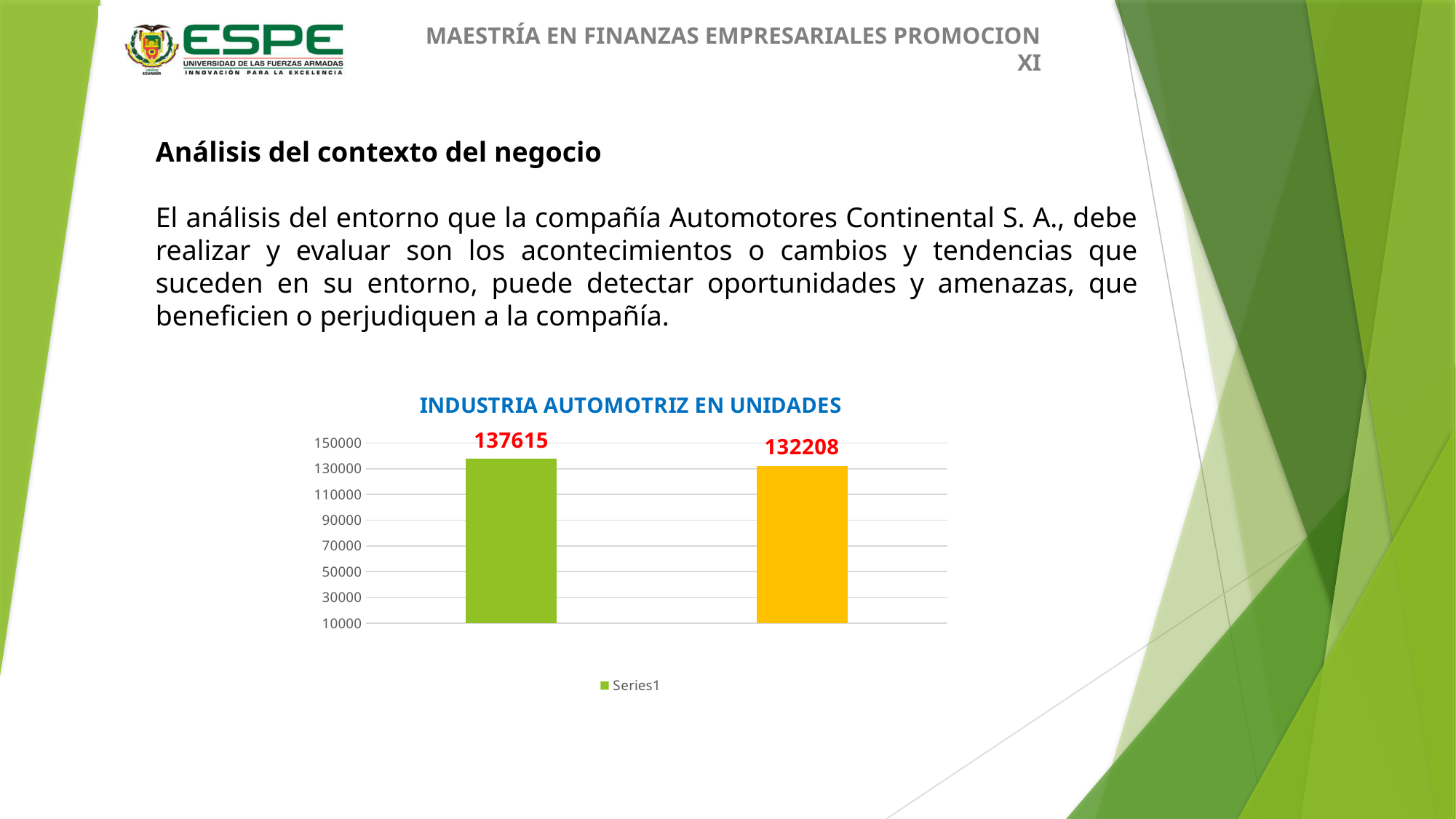
What is the value shown on the green (left) bar in the chart? 137615 Which bar has the higher value, the green (left) bar or the yellow (right) bar? the green (left) bar What is the name of the series shown in the legend? Series1 Is the value of the yellow (right) bar greater or less than 130000? greater Which bar shows the lowest value in the chart? the yellow (right) bar Do the values rise or fall from the left bar to the right bar? fall What is the difference between the values of the green bar and the yellow bar? 5407 What is the title of the chart? INDUSTRIA AUTOMOTRIZ EN UNIDADES How many series does the legend list? 1 What is the value shown on the yellow (right) bar in the chart? 132208 How many bars are plotted in the chart? 2 What kind of chart is shown on the slide? bar chart